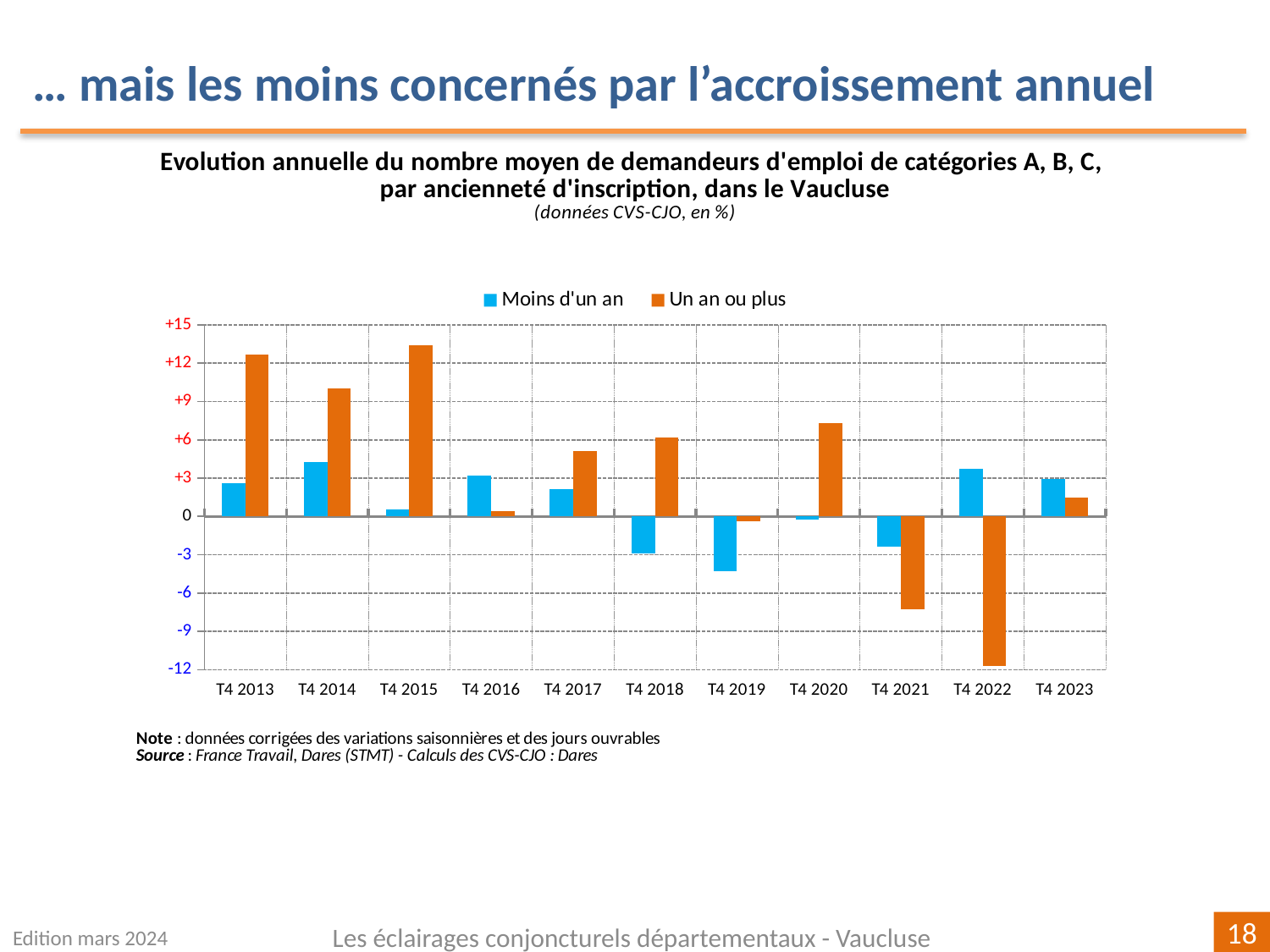
Which colour represents the 'Un an ou plus' series in the legend? Orange In T4 2022, which series has the larger value, 'Moins d'un an' or 'Un an ou plus'? Moins d'un an Which period has the lowest value for the 'Un an ou plus' series? T4 2022 Is the value for 'Un an ou plus' in T4 2022 greater or less than -9? less Is the value for 'Moins d'un an' in T4 2019 greater or less than -3? less Is the value for 'Un an ou plus' in T4 2013 greater or less than +12? greater Which period has the highest value for the 'Un an ou plus' series? T4 2015 What kind of chart is shown on the slide? Bar chart Which period has the lowest value for the 'Moins d'un an' series? T4 2019 How many series does the legend list? 2 How many periods (categories) are shown on the x axis? 11